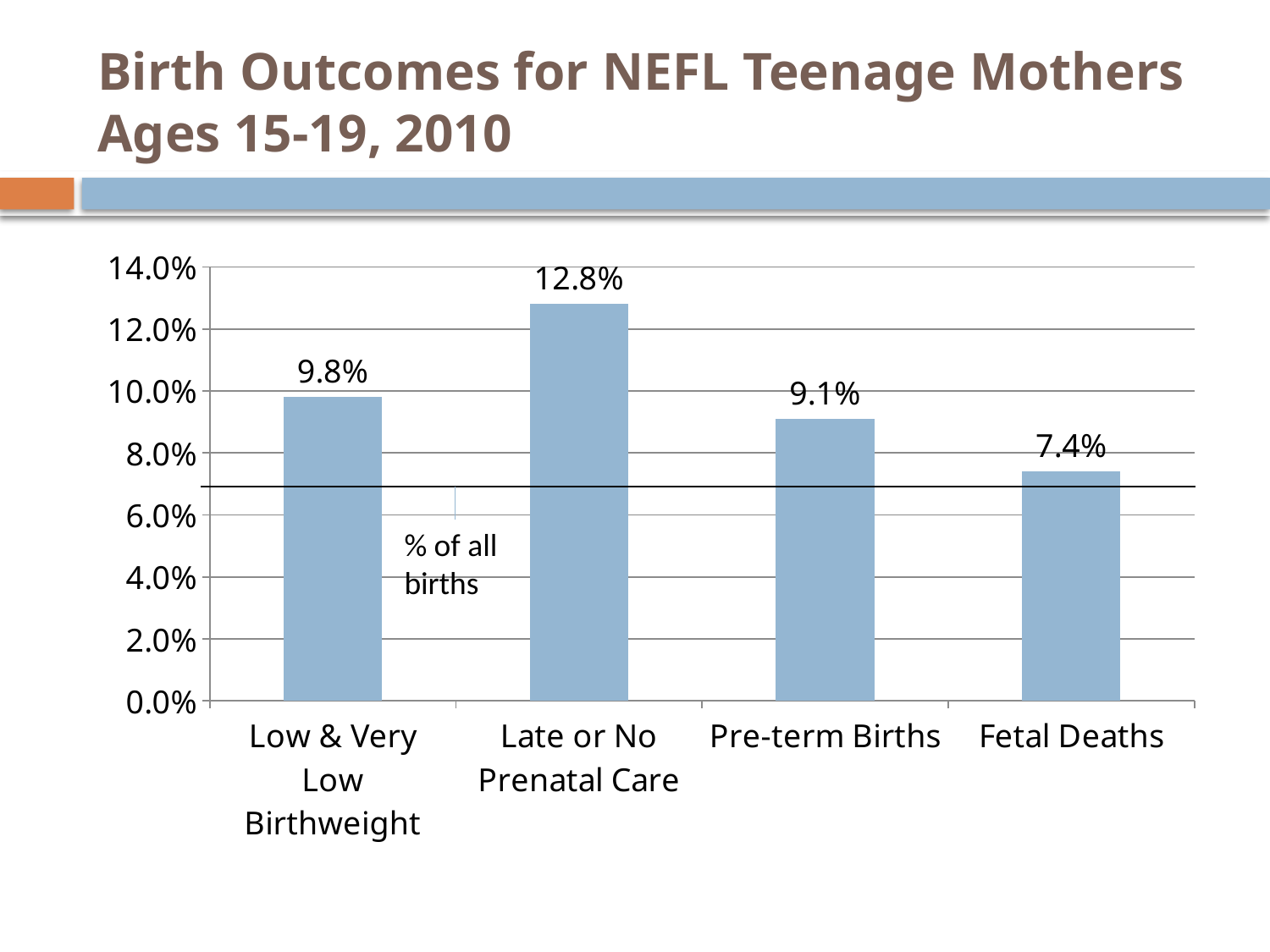
What is the value for Late or No Prenatal Care? 12.8% What is the title of the slide? Birth Outcomes for NEFL Teenage Mothers Ages 15-19, 2010 What is the value for Low & Very Low Birthweight? 9.8% How many categories are shown on the x axis? 4 Which category has the lowest value? Fetal Deaths Which category has the highest value? Late or No Prenatal Care What kind of chart is shown on the slide? Bar chart Which is larger, the value for Low & Very Low Birthweight or the value for Fetal Deaths? Low & Very Low Birthweight What is the difference between the values for Low & Very Low Birthweight and Pre-term Births? 0.7% What is the difference between the values for Late or No Prenatal Care and Fetal Deaths? 5.4% What is the value for Fetal Deaths? 7.4% What is the value for Pre-term Births? 9.1%